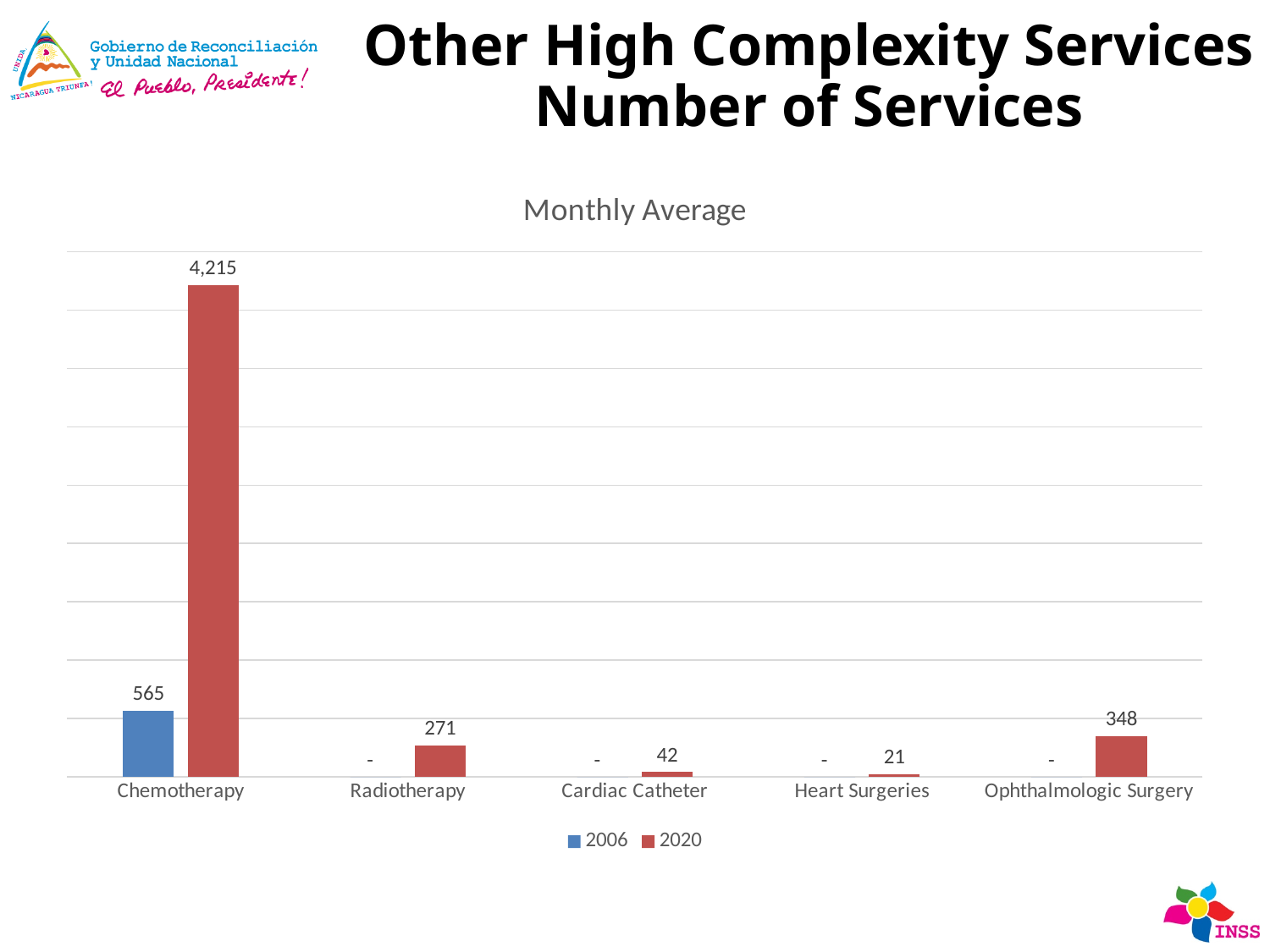
What is the difference between the 2020 and 2006 values for Chemotherapy? 3,650 What is the 2006 value for Chemotherapy? 565 What is the 2020 value for Radiotherapy? 271 What type of chart is shown? Bar chart What is the 2020 value for Chemotherapy? 4,215 How many series does the legend list? 2 Which is larger, the 2020 value for Radiotherapy or the 2020 value for Ophthalmologic Surgery? Ophthalmologic Surgery How many categories are shown on the x axis? 5 What is the 2020 value for Ophthalmologic Surgery? 348 Which category has the highest 2020 value? Chemotherapy What is the 2020 value for Heart Surgeries? 21 Which category has the lowest 2020 value? Heart Surgeries